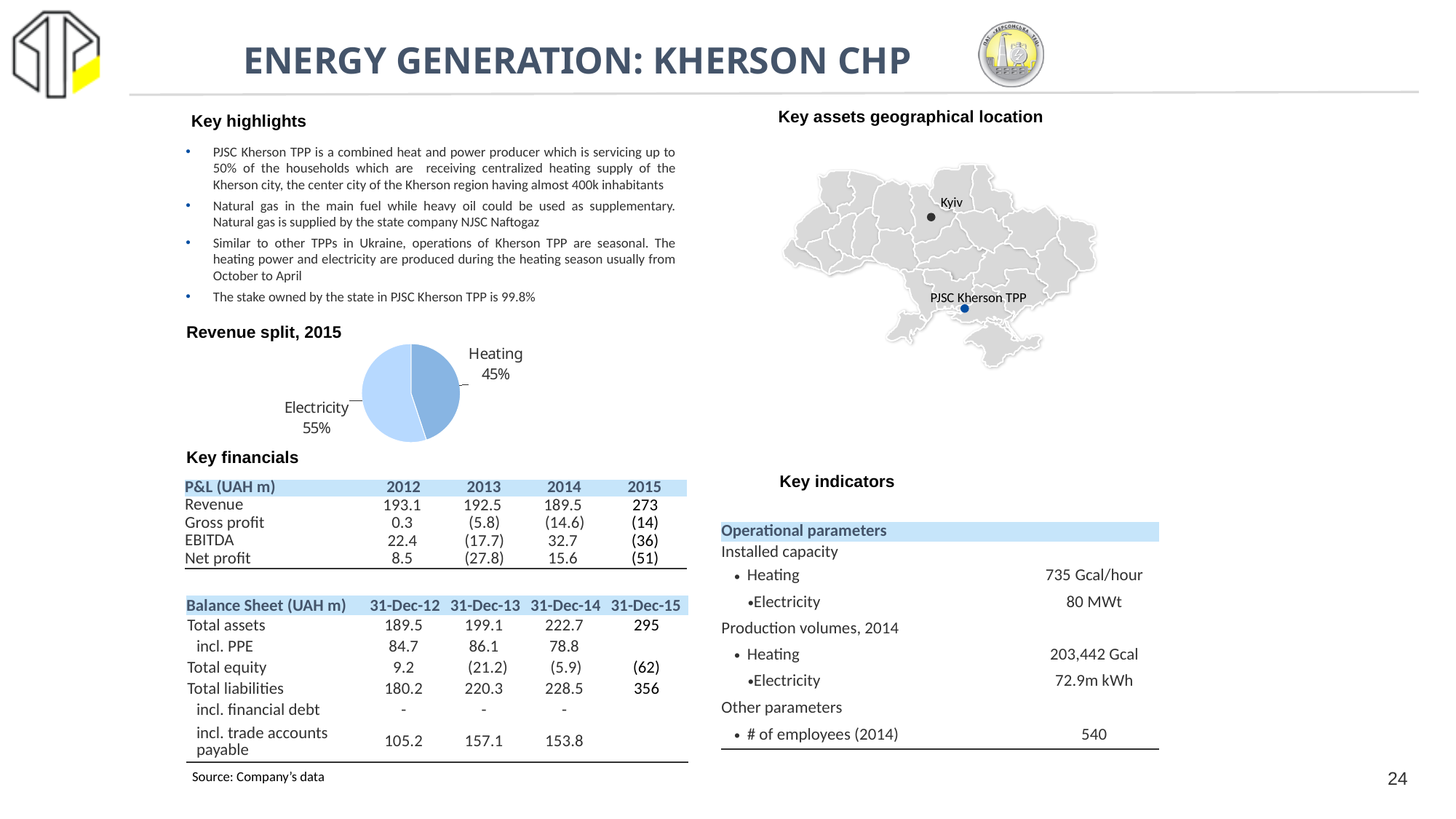
In the "Revenue split, 2015" pie chart, what is the difference in percentage points between the Electricity and Heating shares? 10 percentage points In the "Revenue split, 2015" pie chart, which is larger, Heating or Electricity? Electricity In the "Revenue split, 2015" pie chart, which slice is the largest? Electricity How many slices does the "Revenue split, 2015" pie chart have? 2 What kind of chart is shown under "Revenue split, 2015"? pie chart In the "Revenue split, 2015" pie chart, what share does Electricity have? 55% In the "Revenue split, 2015" pie chart, what share does Heating have? 45% In the "Revenue split, 2015" pie chart, which slice is the smallest? Heating In the "Revenue split, 2015" pie chart, is the Heating share greater or less than 50%? less What is the title of the pie chart on the slide? Revenue split, 2015